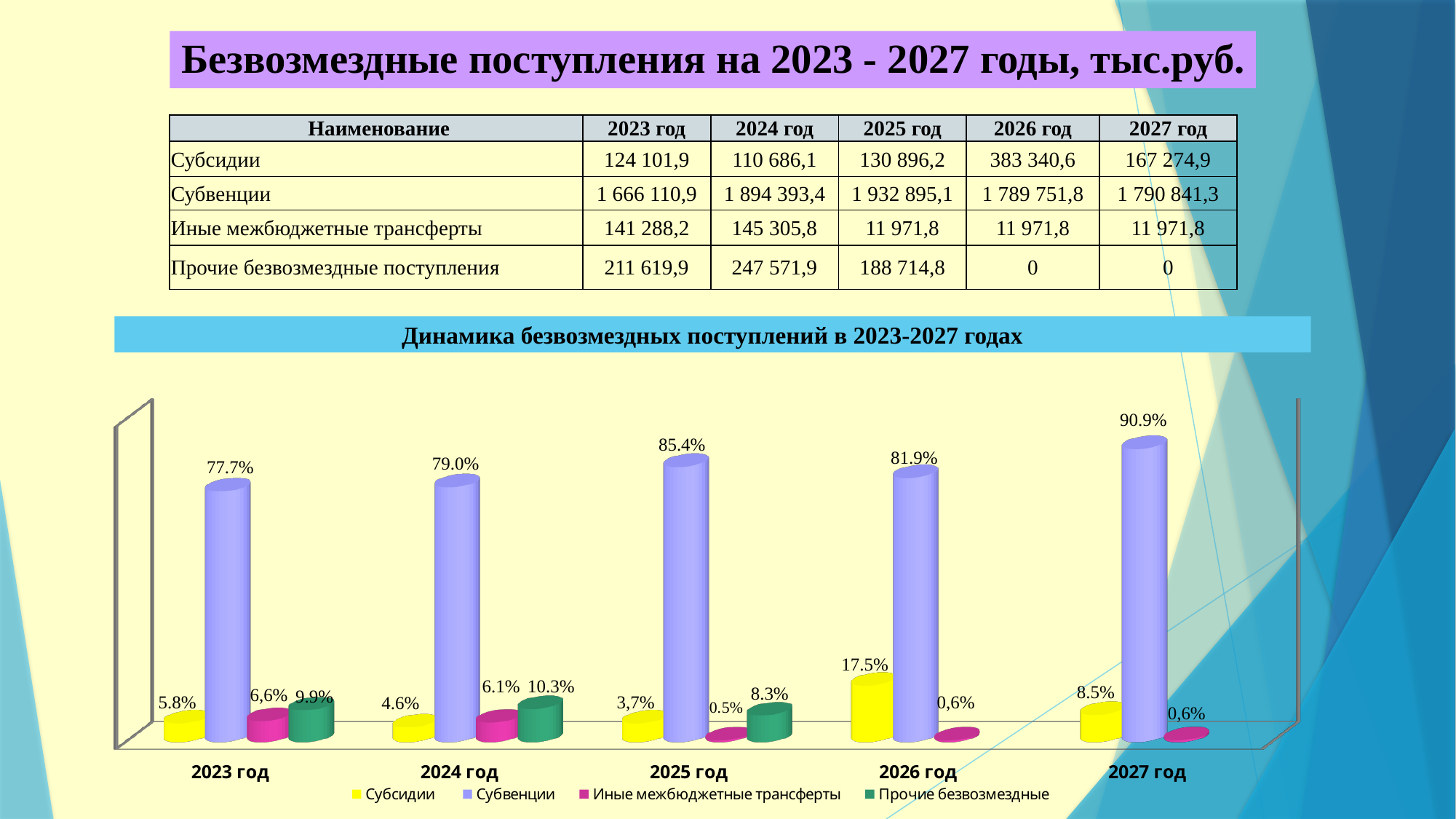
Which colour represents Субвенции in the chart legend? purple What is the value for Иные межбюджетные трансферты in 2025 год on the chart? 0.5% Which is larger on the chart: Субсидии in 2023 год or Прочие безвозмездные in 2023 год? Прочие безвозмездные in 2023 год How many year categories are shown on the x axis of the chart? 5 In which year is the value for Субвенции the highest on the chart? 2027 год What is the value for Субвенции in 2027 год on the chart? 90.9% What is the value for Субсидии in 2026 год on the chart? 17.5% What is the difference between the Субвенции values for 2025 год and 2024 год on the chart? 6.4% In which year is the value for Субсидии the lowest on the chart? 2025 год How many series does the legend of the chart list? 4 What kind of chart is shown under the heading "Динамика безвозмездных поступлений в 2023-2027 годах"? bar chart What is the value for Прочие безвозмездные in 2024 год on the chart? 10.3%